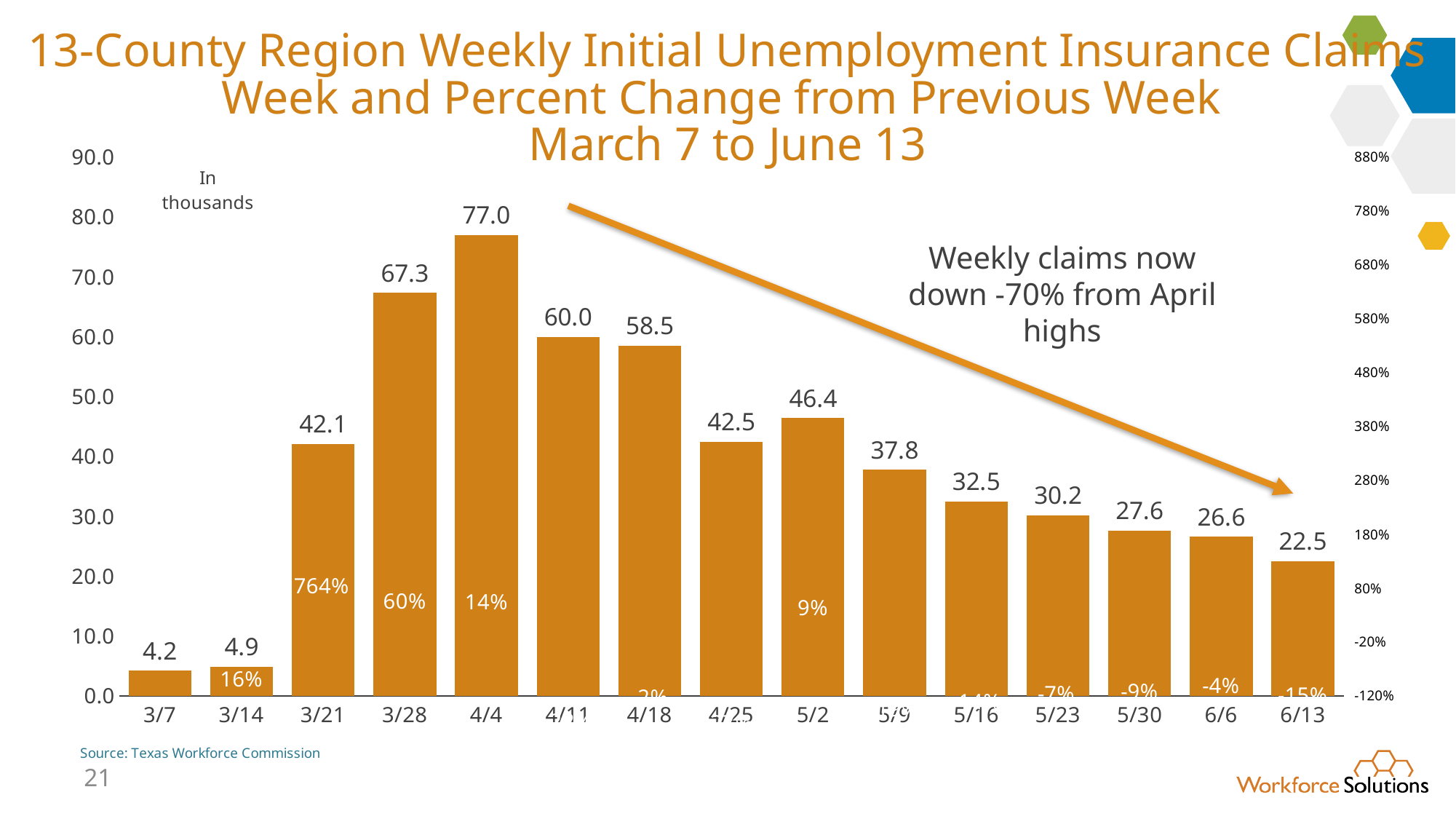
What percent change from the previous week is labeled on the bar for 3/21? 764% What is the value of weekly initial claims (in thousands) for the week of 6/13? 22.5 How many weeks (bars) are plotted in the chart? 15 Which week has the lowest number of weekly initial claims? 3/7 Which week had more initial claims, 4/25 or 5/2? 5/2 What is the value of weekly initial claims (in thousands) for the week of 3/28? 67.3 Which week has the highest number of weekly initial claims? 4/4 Do the weekly initial claims rise or fall from the week of 4/4 through the week of 6/13? fall What is the difference in weekly initial claims (in thousands) between the week of 4/4 and the week of 6/13? 54.5 What kind of chart is shown on the slide? bar chart What is the value of weekly initial claims (in thousands) for the week of 4/4? 77.0 What source is cited for the chart data? Texas Workforce Commission